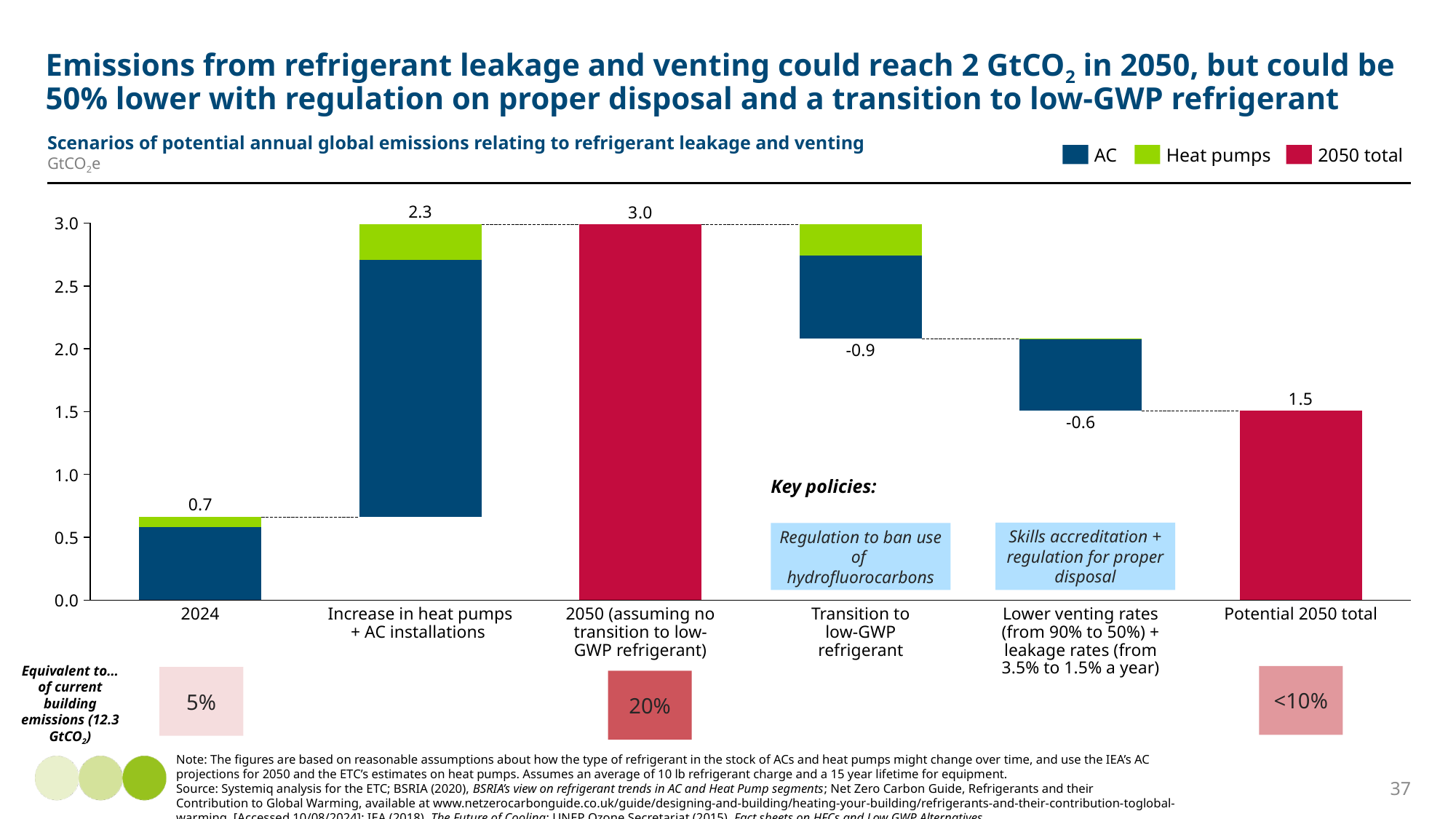
How many categories are shown on the x axis? 6 What is the value shown for '2050 (assuming no transition to low-GWP refrigerant)'? 3.0 What is the value shown for 2024? 0.7 Which category has the highest labelled value? 2050 (assuming no transition to low-GWP refrigerant) How many series does the legend list? 3 What is the difference between the 2050 total assuming no transition to low-GWP refrigerant and the potential 2050 total? 1.5 Which is larger: the 2050 total assuming no transition to low-GWP refrigerant or the potential 2050 total? 2050 (assuming no transition to low-GWP refrigerant) What kind of chart is shown on the slide? bar chart What is the value shown for 'Lower venting rates (from 90% to 50%) + leakage rates (from 3.5% to 1.5% a year)'? -0.6 What is the value shown for 'Transition to low-GWP refrigerant'? -0.9 What is the value shown for 'Potential 2050 total'? 1.5 What is the value shown for 'Increase in heat pumps + AC installations'? 2.3